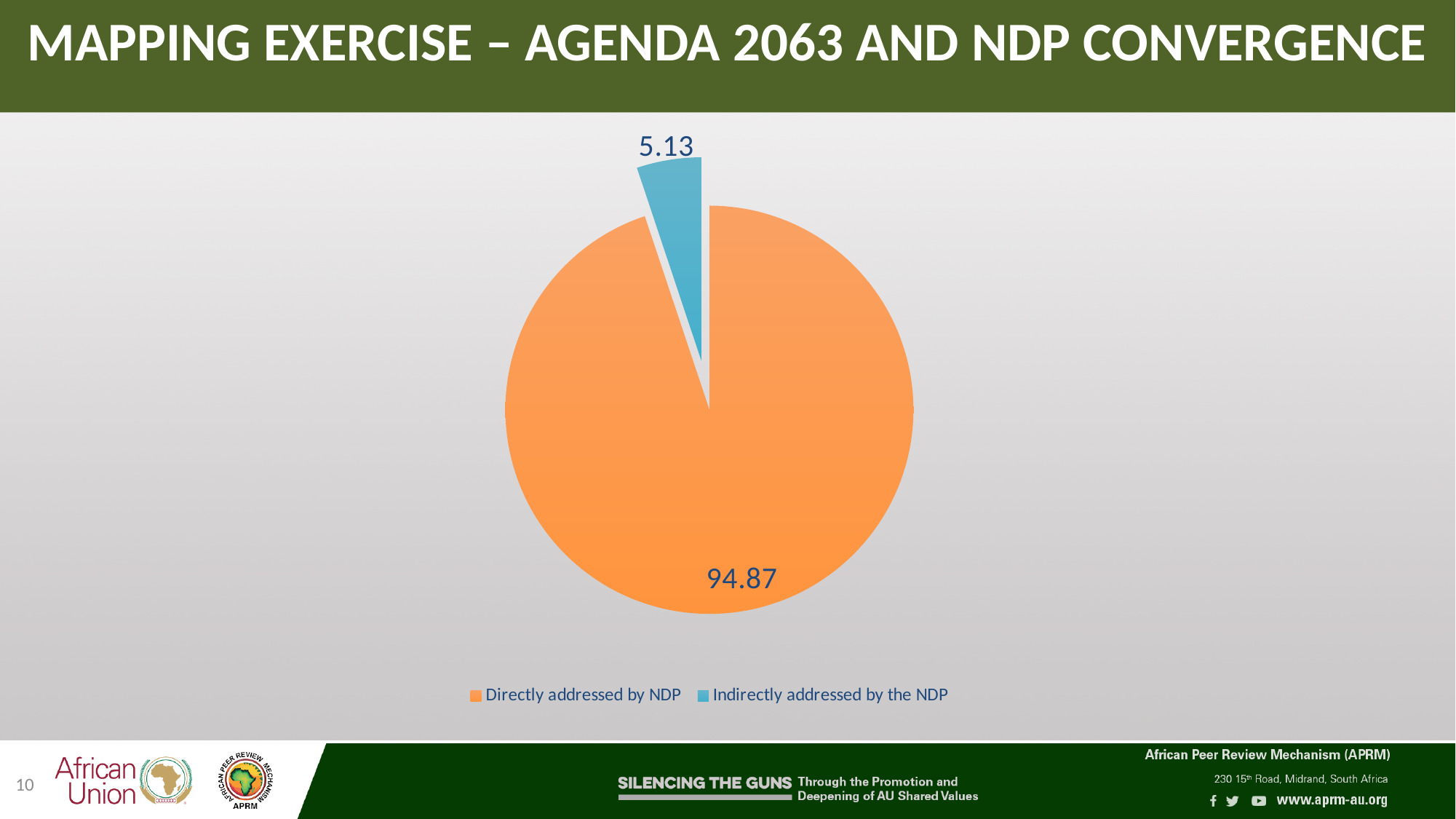
What is the value for "Directly addressed by NDP"? 94.87 How many slices does the pie chart have? 2 What colour is the slice for "Directly addressed by NDP"? Orange Which is larger: "Directly addressed by NDP" or "Indirectly addressed by the NDP"? Directly addressed by NDP What is the value for "Indirectly addressed by the NDP"? 5.13 What is the total of the two slice values shown on the pie chart? 100 What colour is the slice for "Indirectly addressed by the NDP"? Blue What is the difference between the values for "Directly addressed by NDP" and "Indirectly addressed by the NDP"? 89.74 Which category has the largest slice of the pie? Directly addressed by NDP How many entries does the legend list? 2 Which category has the smallest slice of the pie? Indirectly addressed by the NDP What kind of chart is shown on the slide? Pie chart